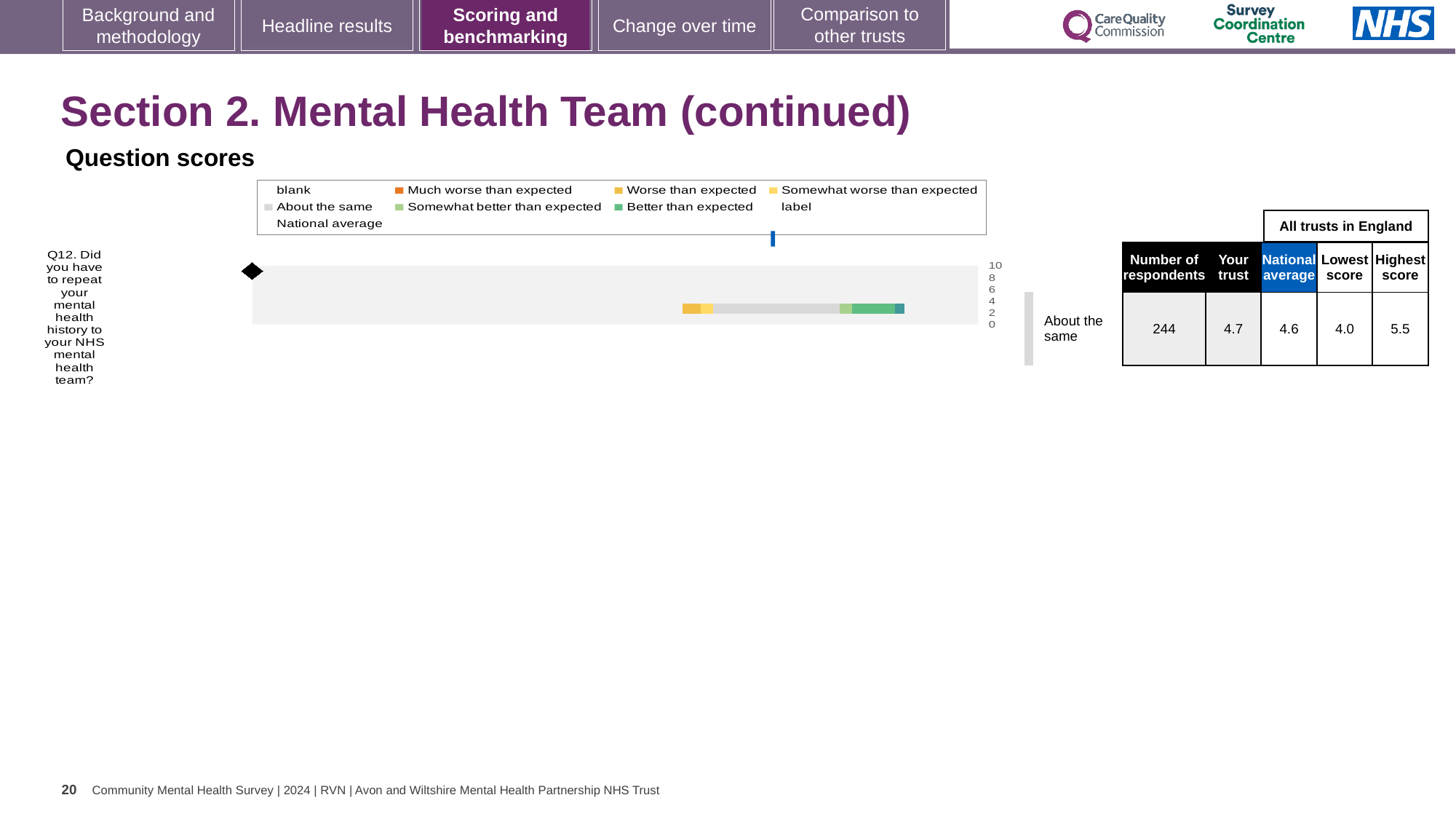
What is the benchmark category shown for Q12? About the same How many questions are plotted in the chart? 1 Which question is plotted in the chart? Q12. Did you have to repeat your mental health history to your NHS mental health team? How many respondents answered Q12? 244 What is the difference between the 'Your trust' score and the national average for Q12? 0.1 What is the lowest score among all trusts in England for Q12? 4.0 What is the 'Your trust' score for Q12? 4.7 What kind of chart is shown on the slide? bar chart What is the national average score for Q12? 4.6 Which is larger for Q12, the 'Your trust' score or the national average? Your trust What is the highest score among all trusts in England for Q12? 5.5 What is the difference between the highest and lowest scores for Q12? 1.5